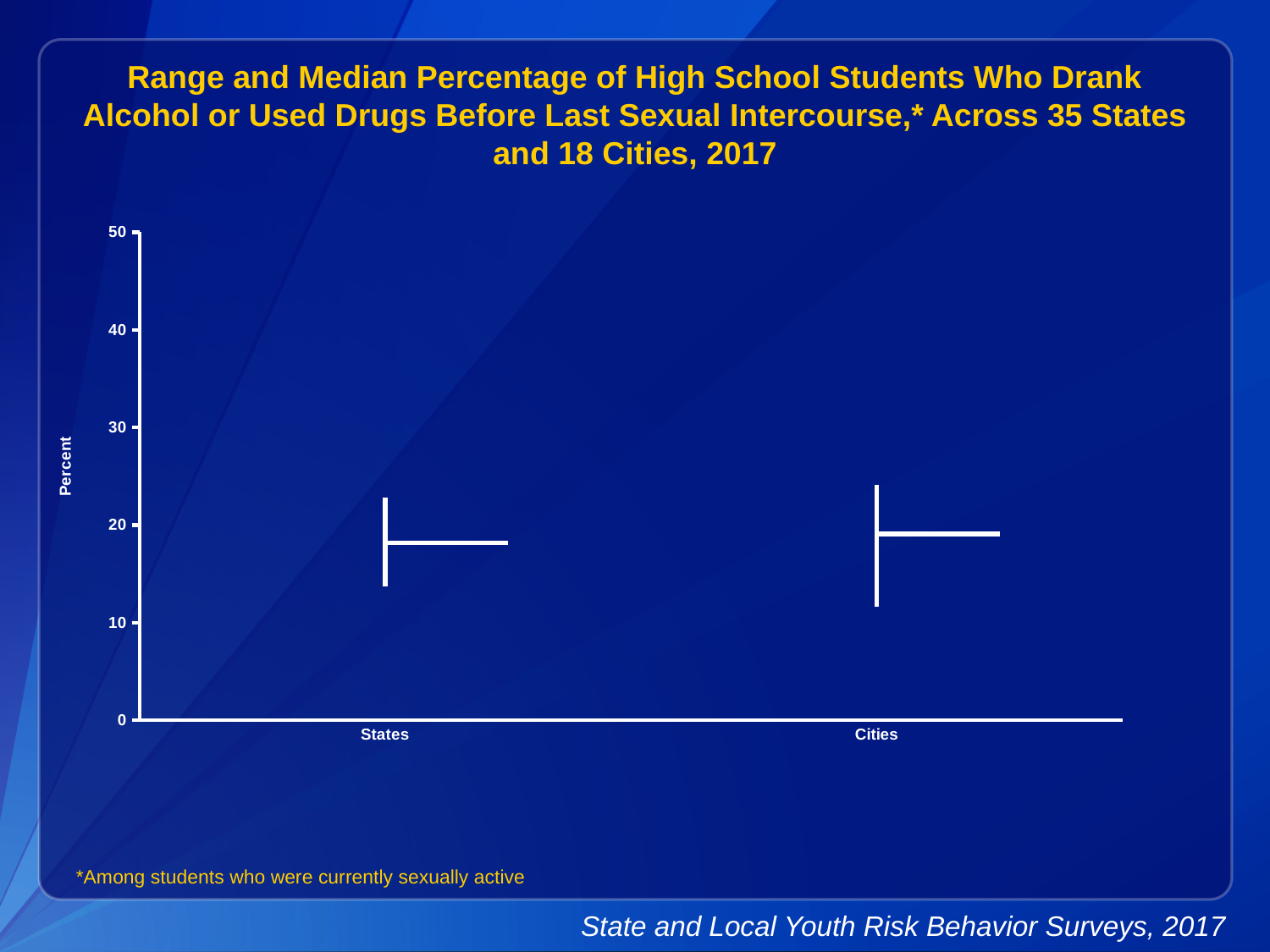
Is the bottom of the range for Cities greater or less than 10? greater Is the top of the range for States greater or less than 20? greater What is the highest value shown on the y axis of the chart? 50 What are the two categories shown on the x axis? States and Cities Is the top of the range for Cities greater or less than 20? greater Which category has the wider range, States or Cities? Cities What is the label on the y axis of the chart? Percent How many categories are shown on the x axis of the chart? 2